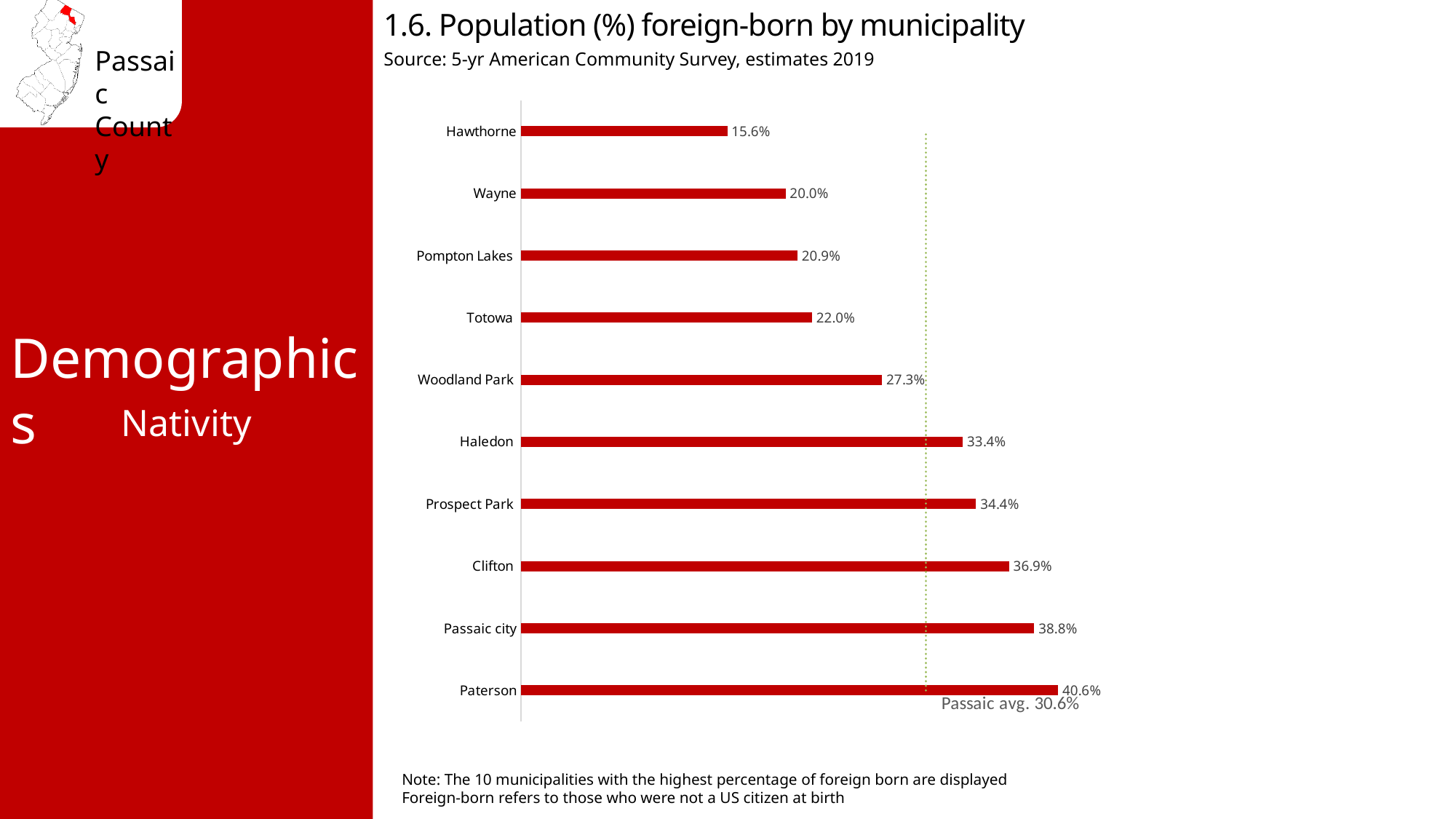
How many municipalities are shown in the chart? 10 Which municipality has the highest percentage of foreign-born population? Paterson What is the Passaic County average foreign-born percentage marked on the chart? 30.6% What is the percentage of foreign-born population in Woodland Park? 27.3% Which municipality has the lowest percentage of foreign-born population? Hawthorne What kind of chart is used to show the foreign-born population by municipality? Bar chart What is the difference in foreign-born percentage between Paterson and Passaic city? 1.8% What is the percentage of foreign-born population in Hawthorne? 15.6% What is the source of the data shown in the chart? 5-yr American Community Survey, estimates 2019 Which has a higher foreign-born percentage, Wayne or Pompton Lakes? Pompton Lakes What is the percentage of foreign-born population in Clifton? 36.9% What is the difference in foreign-born percentage between Haledon and Totowa? 11.4%